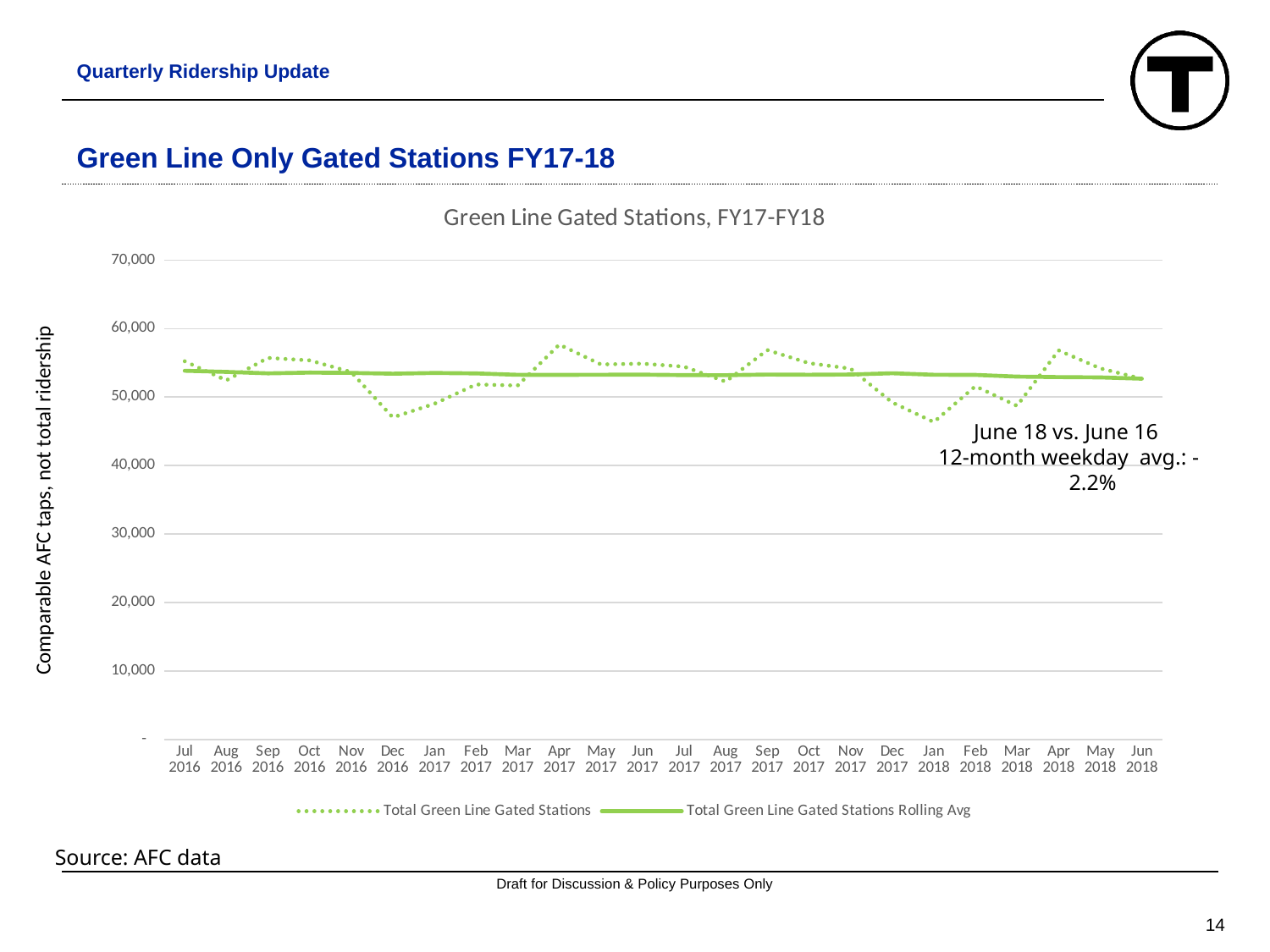
What change in the 12-month weekday average does the annotation give for June 18 vs. June 16? -2.2% Is the value for Total Green Line Gated Stations in Jan 2018 greater or less than 50,000? less Does the Total Green Line Gated Stations Rolling Avg line rise or fall from Jul 2016 to Jun 2018? fall Is the value for Total Green Line Gated Stations in Dec 2016 greater or less than 50,000? less What is the title of the chart? Green Line Gated Stations, FY17-FY18 How many months are plotted along the x axis? 24 Which is larger for Total Green Line Gated Stations: Jan 2018 or Apr 2018? Apr 2018 How many series does the legend list? 2 Is the value for Total Green Line Gated Stations in Apr 2017 greater or less than 50,000? greater What kind of chart is shown on the slide? line chart Which is larger for Total Green Line Gated Stations: Dec 2016 or Apr 2017? Apr 2017